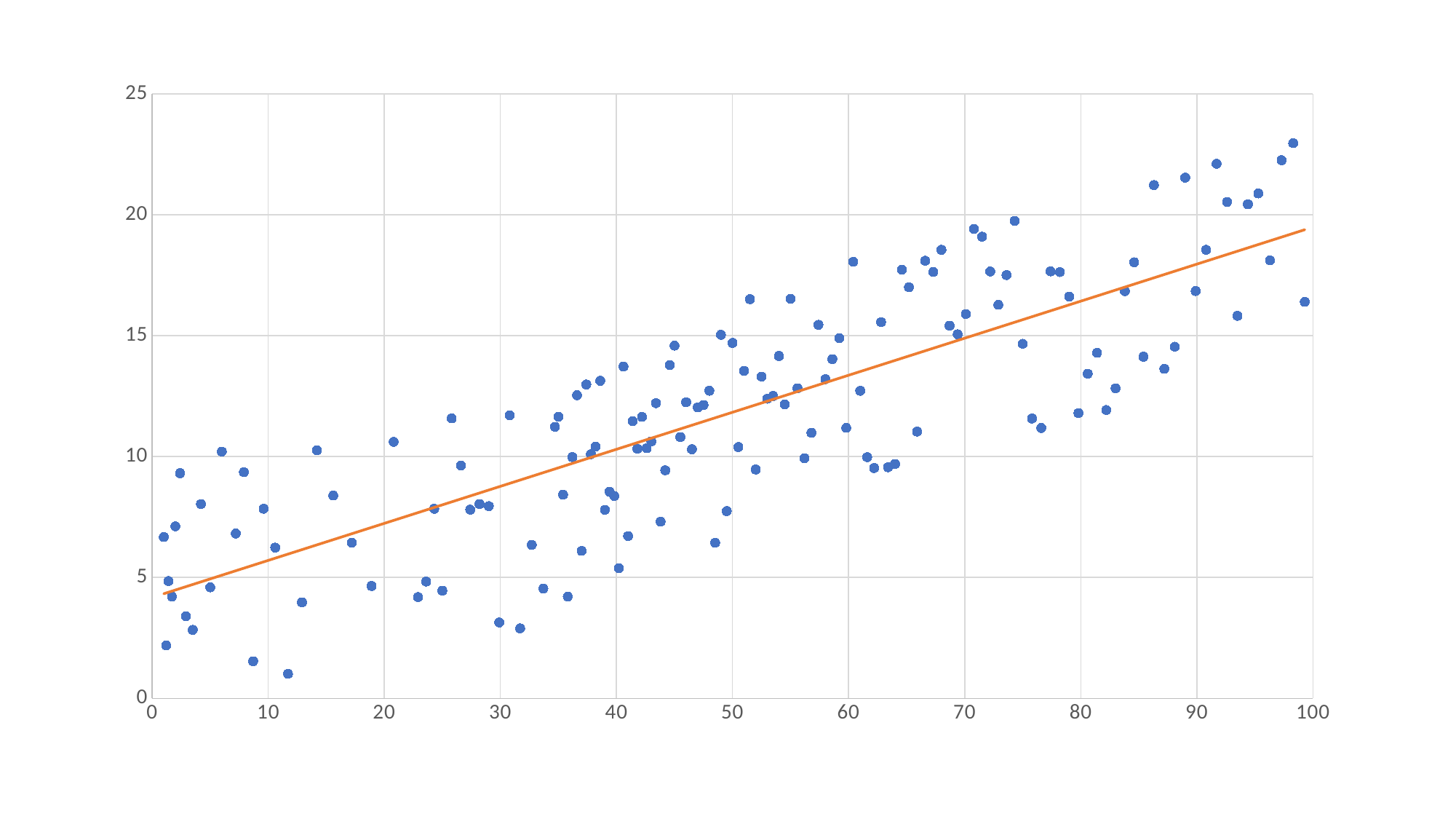
Is the lowest plotted point greater or less than 5 on the y axis? less Does the orange trend line slope upward or downward from left to right? Upward What kind of chart is shown on the slide? Scatter chart What is the highest value shown on the y axis? 25 Do the plotted points generally rise or fall as the x value increases? Rise What is the highest value shown on the x axis? 100 Is the value of the trend line at x = 100 greater or less than 15? greater Is the value of the trend line at x = 0 greater or less than 5? less